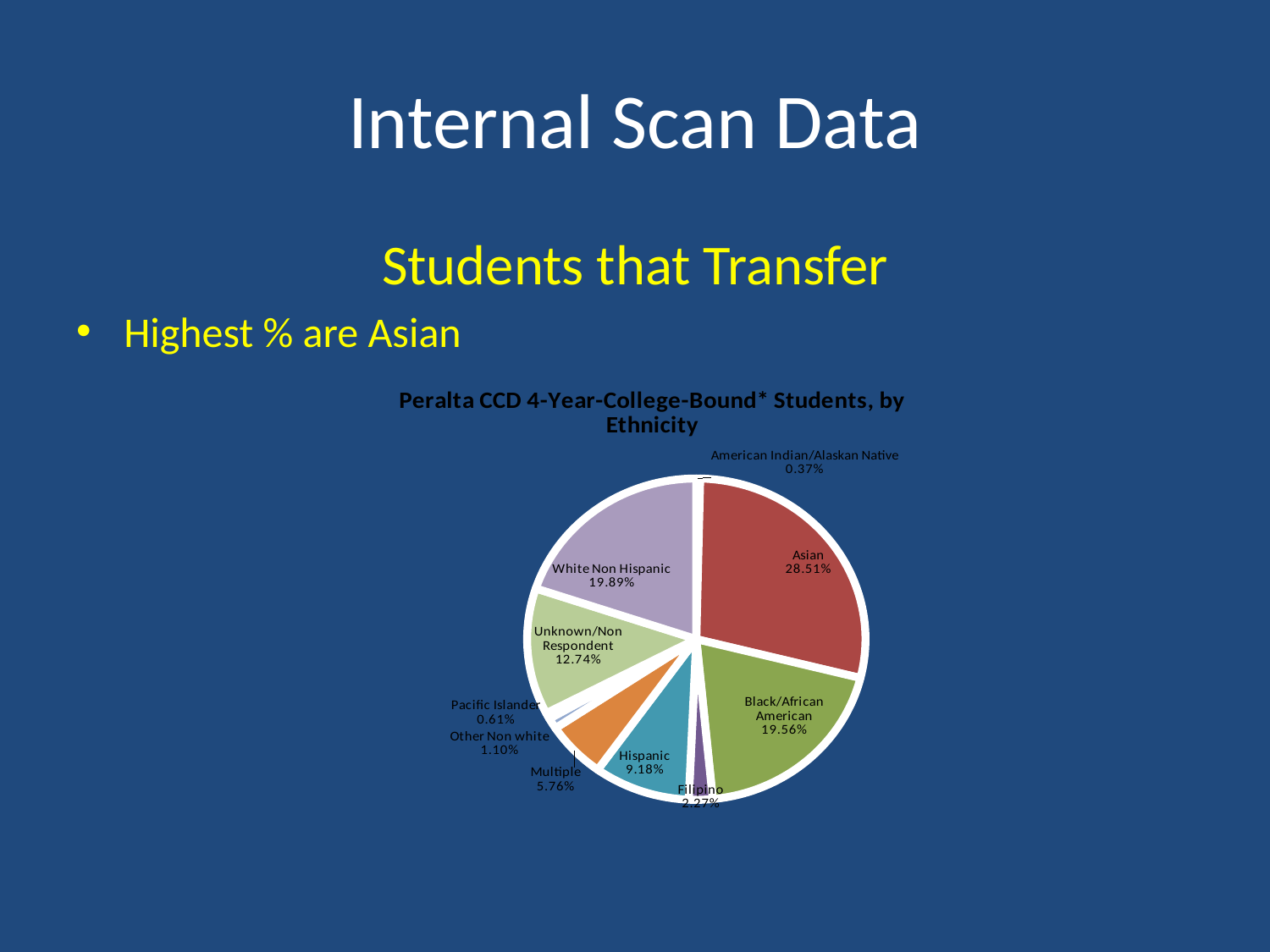
What percentage is shown for White Non Hispanic? 19.89% Which ethnicity has the largest share of the pie? Asian What percentage is shown for Unknown/Non Respondent? 12.74% Which is larger, the Multiple slice or the Filipino slice? Multiple What is the difference in percentage points between the Asian and Black/African American slices? 8.95 What is the title of the chart? Peralta CCD 4-Year-College-Bound* Students, by Ethnicity What type of chart is shown on the slide? Pie chart Which ethnicity has the smallest share of the pie? American Indian/Alaskan Native What percentage is shown for Hispanic? 9.18% How many slices does the pie chart have? 10 What percentage of the pie is the Asian slice? 28.51% What percentage is shown for Black/African American? 19.56%